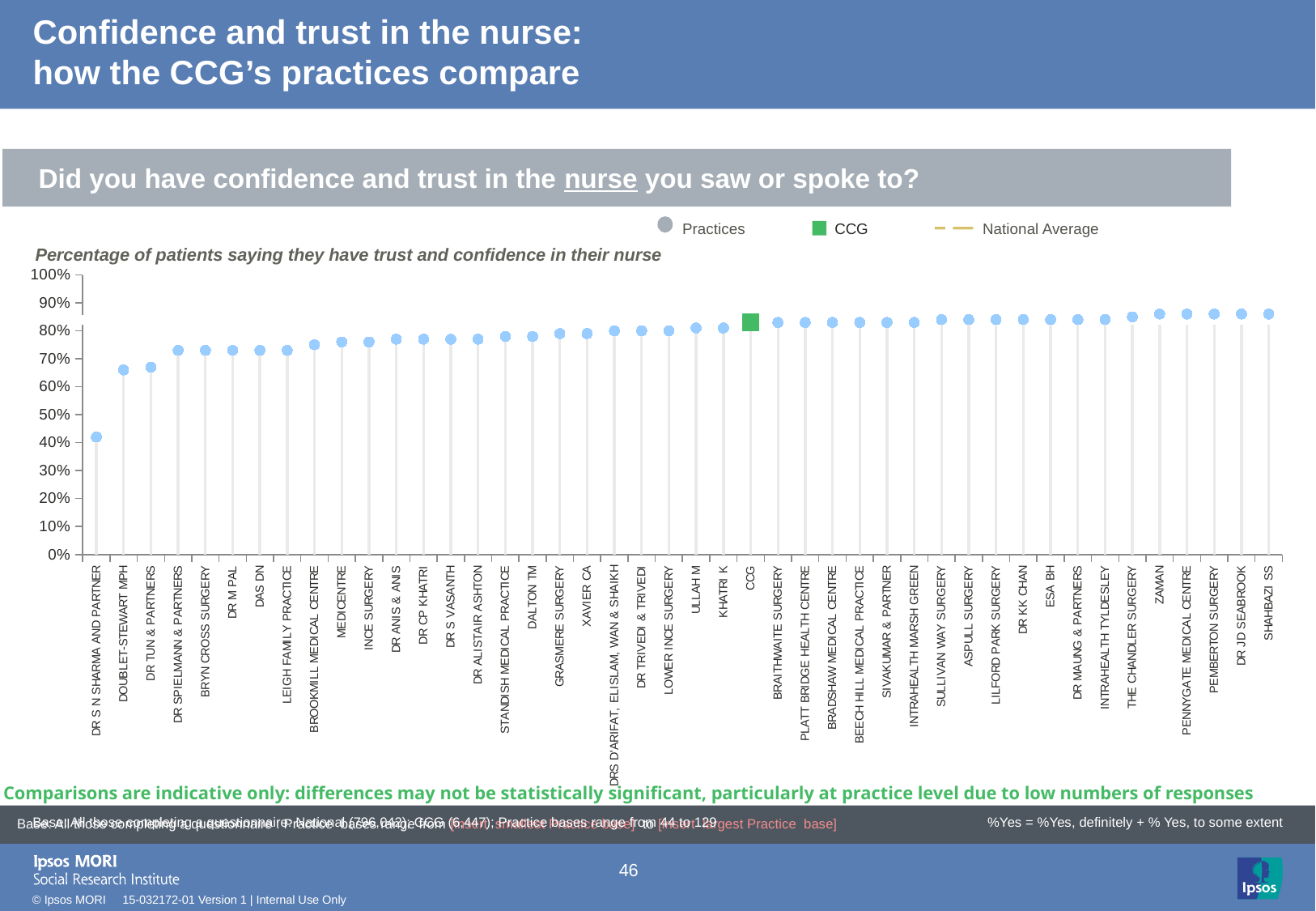
Is the value for BRYN CROSS SURGERY greater or less than 70%? greater Which practice has the lowest percentage of patients saying they have trust and confidence in their nurse? DR S N SHARMA AND PARTNER Do the values rise or fall moving from left to right along the x axis? rise How many entries does the chart legend list? 3 What colour is the marker used for the CCG in the chart? green Which has the higher value, DOUBLET-STEWART MPH or BRYN CROSS SURGERY? BRYN CROSS SURGERY Is the value for DR S N SHARMA AND PARTNER greater or less than 50%? less Is the value for SHAHBAZI SS greater or less than 80%? greater What is the subtitle describing what the chart plots? Percentage of patients saying they have trust and confidence in their nurse Which has the higher value, DR S N SHARMA AND PARTNER or SHAHBAZI SS? SHAHBAZI SS